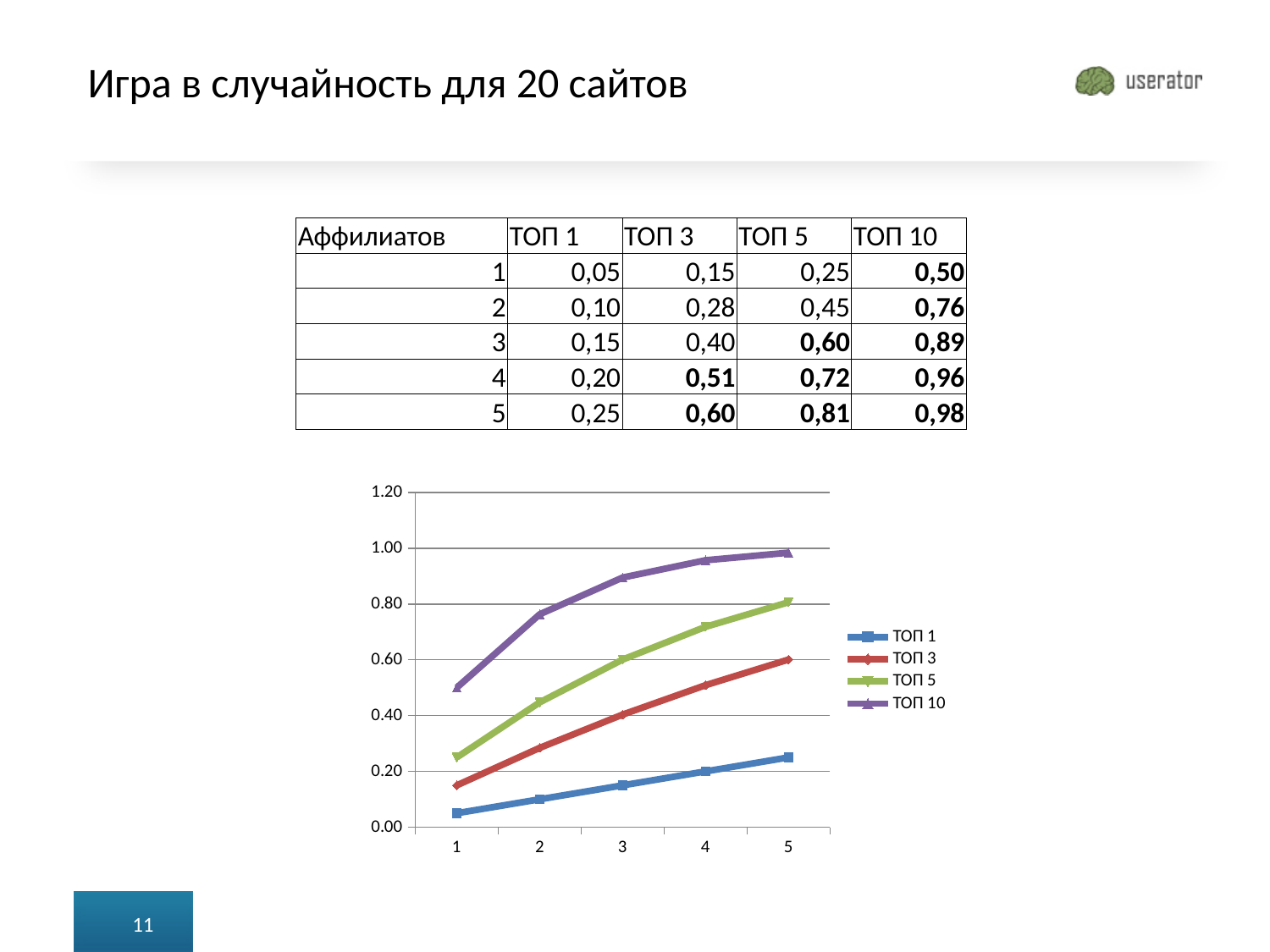
Which is larger at x = 2: the value for ТОП 3 or the value for ТОП 5? ТОП 5 What kind of chart is shown on the slide? line chart Do the values of the ТОП 10 series rise or fall as x increases from 1 to 5? rise According to the table on the slide, what is the value for ТОП 10 at 1 affiliate? 0,50 How many series does the chart legend list? 4 According to the table on the slide, what is the difference between the ТОП 5 and ТОП 1 values at 5 affiliates? 0,56 Is the value of ТОП 1 at x = 5 greater or less than 0.40? less Which legend entry is drawn in purple? ТОП 10 Is the value of ТОП 5 at x = 3 greater or less than 0.40? greater Which series has the highest value at x = 5? ТОП 10 Which series has the lowest value at x = 1? ТОП 1 How many points are plotted along the x axis for each series? 5